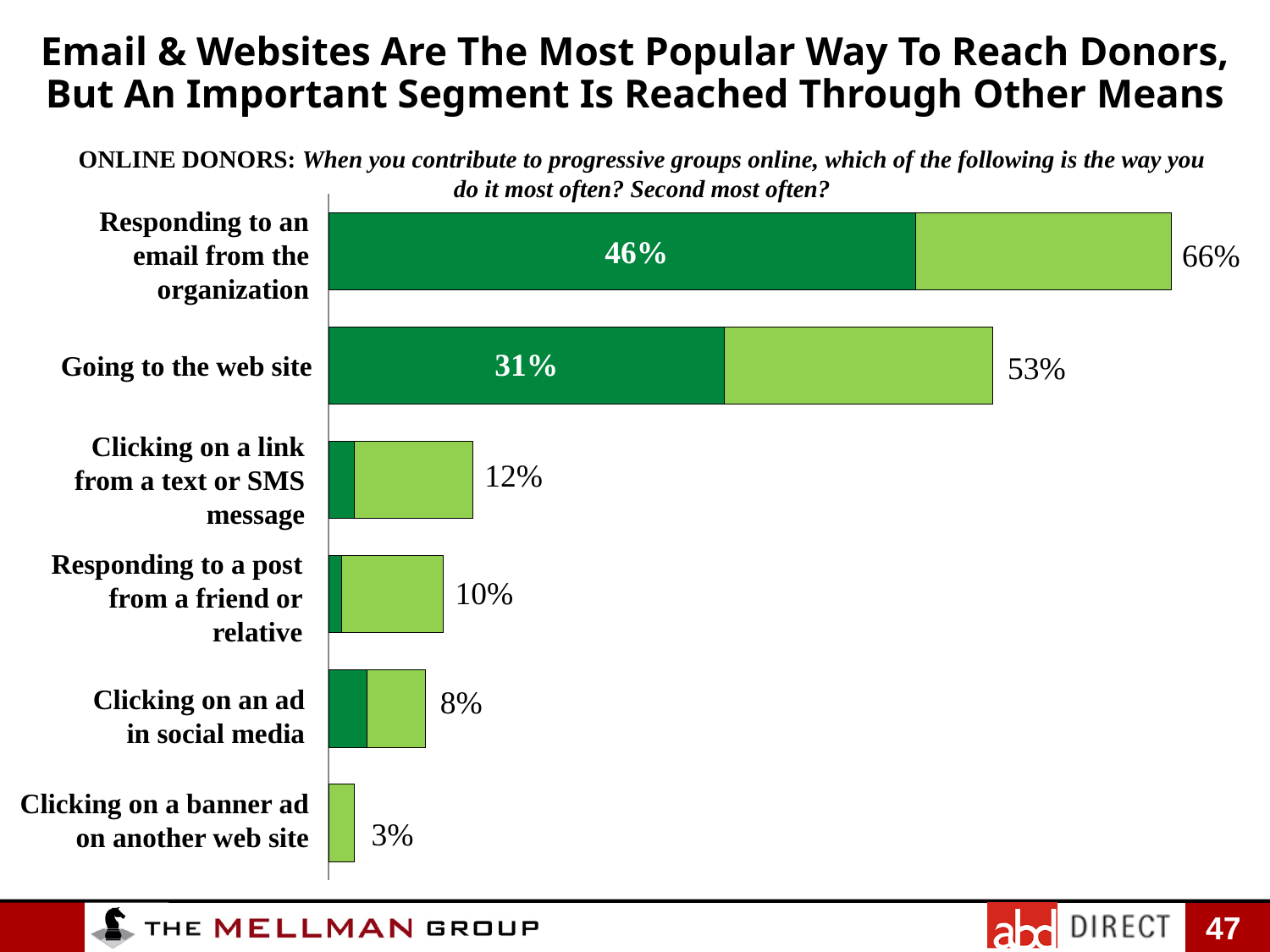
Which category has the highest total value? Responding to an email from the organization What is the total value shown for "Responding to an email from the organization"? 66% What value is printed inside the dark green segment of the "Going to the web site" bar? 31% What is the value shown for "Clicking on a banner ad on another web site"? 3% What kind of chart is shown on the slide? Bar chart Which is larger: the value for "Responding to a post from a friend or relative" or the value for "Clicking on an ad in social media"? Responding to a post from a friend or relative What value is printed inside the dark green segment of the "Responding to an email from the organization" bar? 46% What is the total value shown for "Going to the web site"? 53% How many categories are shown in the chart? 6 What is the value shown for "Clicking on a link from a text or SMS message"? 12% Which category has the lowest value? Clicking on a banner ad on another web site What is the difference between the total for "Responding to an email from the organization" (66%) and the total for "Going to the web site" (53%)? 13%